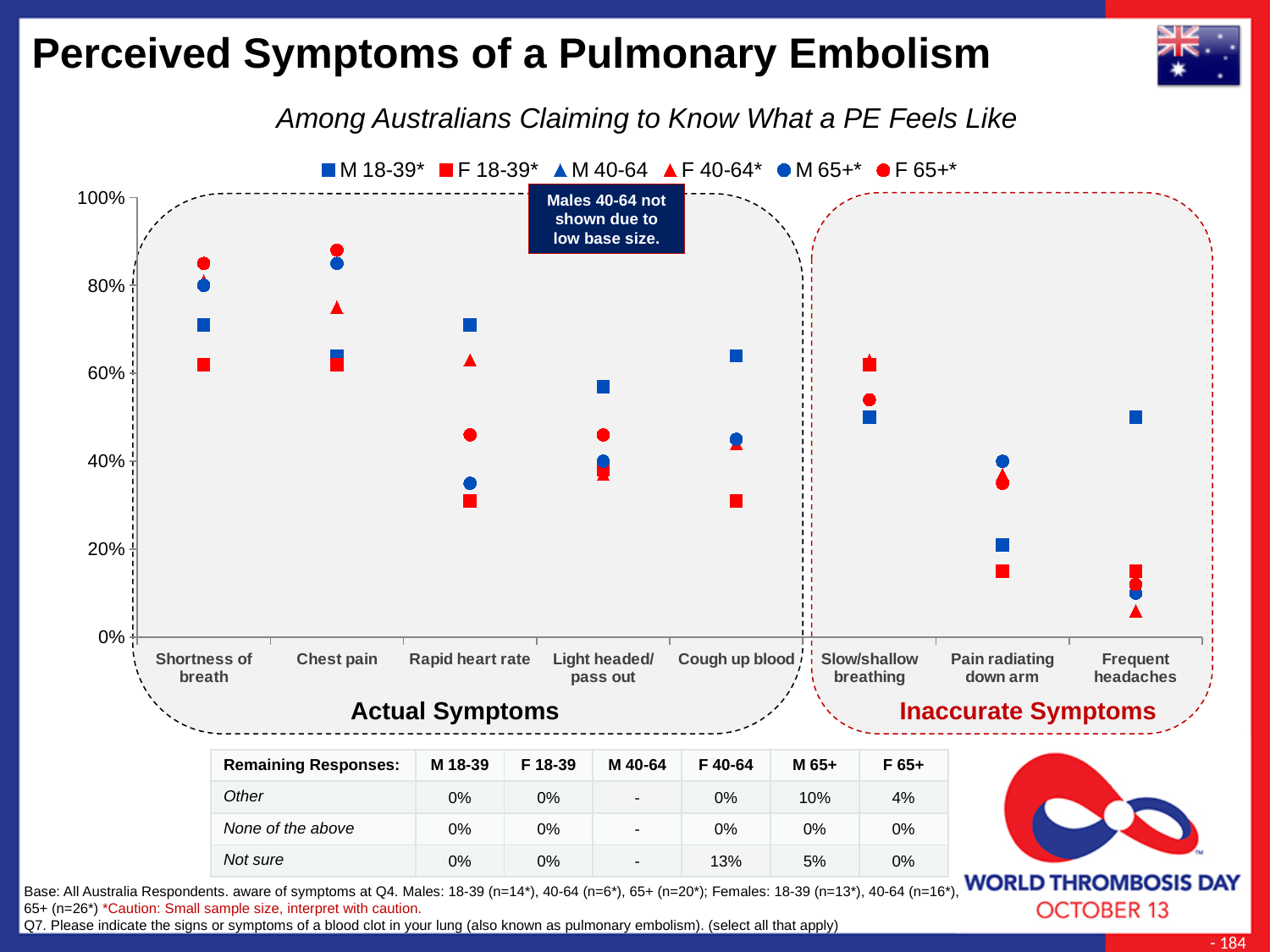
How many symptom categories are plotted along the x axis? 8 Is the value for M 18-39 for 'Shortness of breath' greater or less than 60%? greater Is the value for F 18-39 for 'Cough up blood' greater or less than 40%? less For the M 18-39 series, which symptom has the lowest value? Pain radiating down arm Is the value for F 65+ for 'Chest pain' greater or less than 80%? greater How many series does the chart legend list? 6 For 'Shortness of breath', which is higher: M 18-39 or F 18-39? M 18-39 What kind of chart is shown on the slide? Scatter (dot) chart For 'Frequent headaches', which is higher: M 18-39 or M 65+? M 18-39 According to the note on the chart, why is the M 40-64 series not shown? Low base size How many categories are grouped under 'Inaccurate Symptoms'? 3